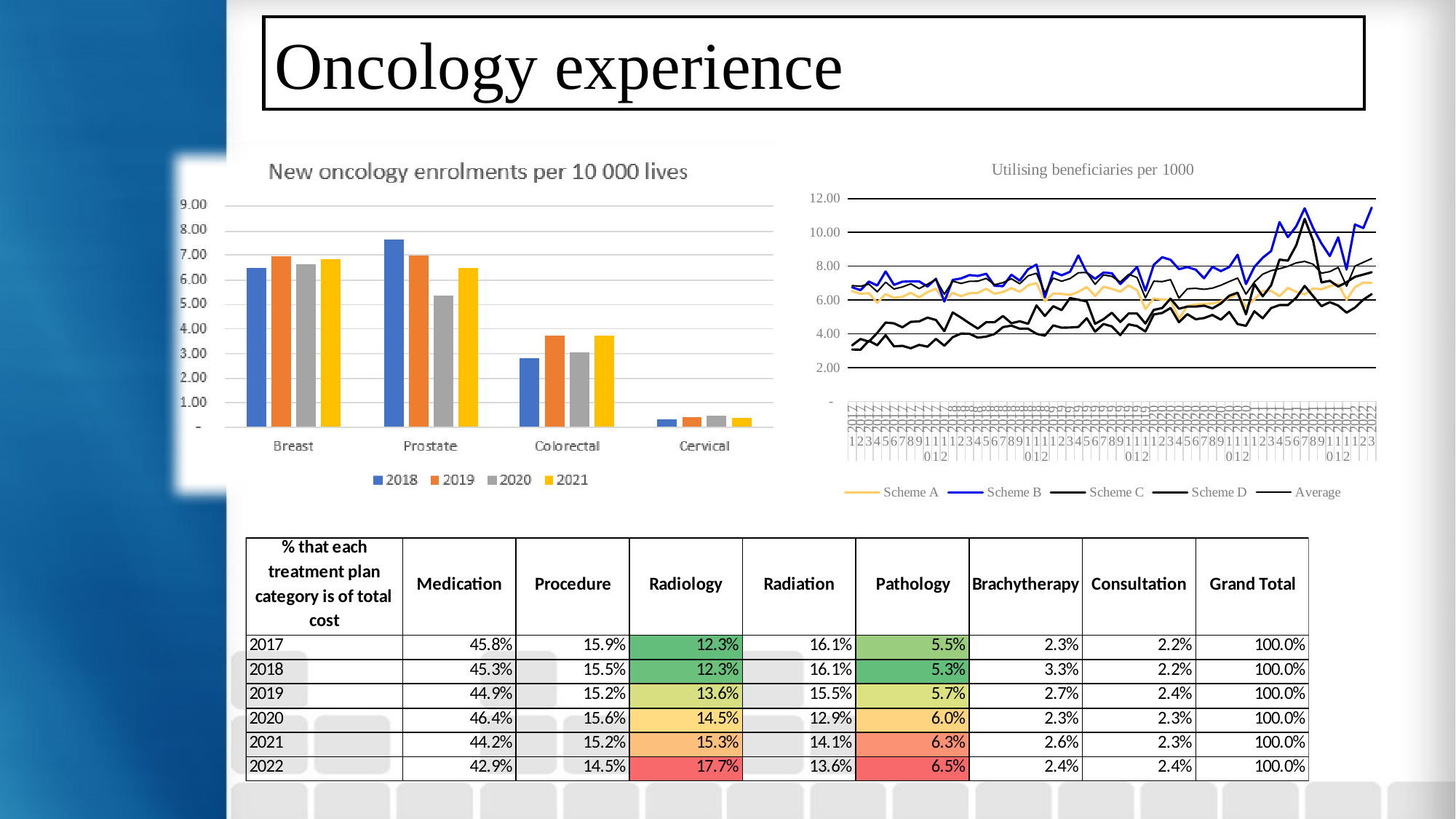
In the 'New oncology enrolments per 10 000 lives' chart, is the 2019 value for Breast greater or less than 6.00? greater How many series does the legend of the 'Utilising beneficiaries per 1000' chart list? 5 How many cancer categories are shown on the x axis of the 'New oncology enrolments per 10 000 lives' chart? 4 In the 'New oncology enrolments per 10 000 lives' chart, which is larger for Colorectal: the 2018 value or the 2019 value? 2019 In the 'New oncology enrolments per 10 000 lives' chart, is the 2020 value for Prostate greater or less than 6.00? less In the 'Utilising beneficiaries per 1000' chart, is the highest value reached by Scheme B greater or less than 10.00? greater How many series does the legend of the 'New oncology enrolments per 10 000 lives' chart list? 4 In the 'New oncology enrolments per 10 000 lives' chart, which category has the lowest values across all years? Cervical What kind of chart is 'New oncology enrolments per 10 000 lives'? Bar chart In the 'New oncology enrolments per 10 000 lives' chart, which category has the highest value for 2018? Prostate What kind of chart is 'Utilising beneficiaries per 1000'? Line chart In the 'New oncology enrolments per 10 000 lives' chart, which is larger for Prostate: the 2018 value or the 2020 value? 2018